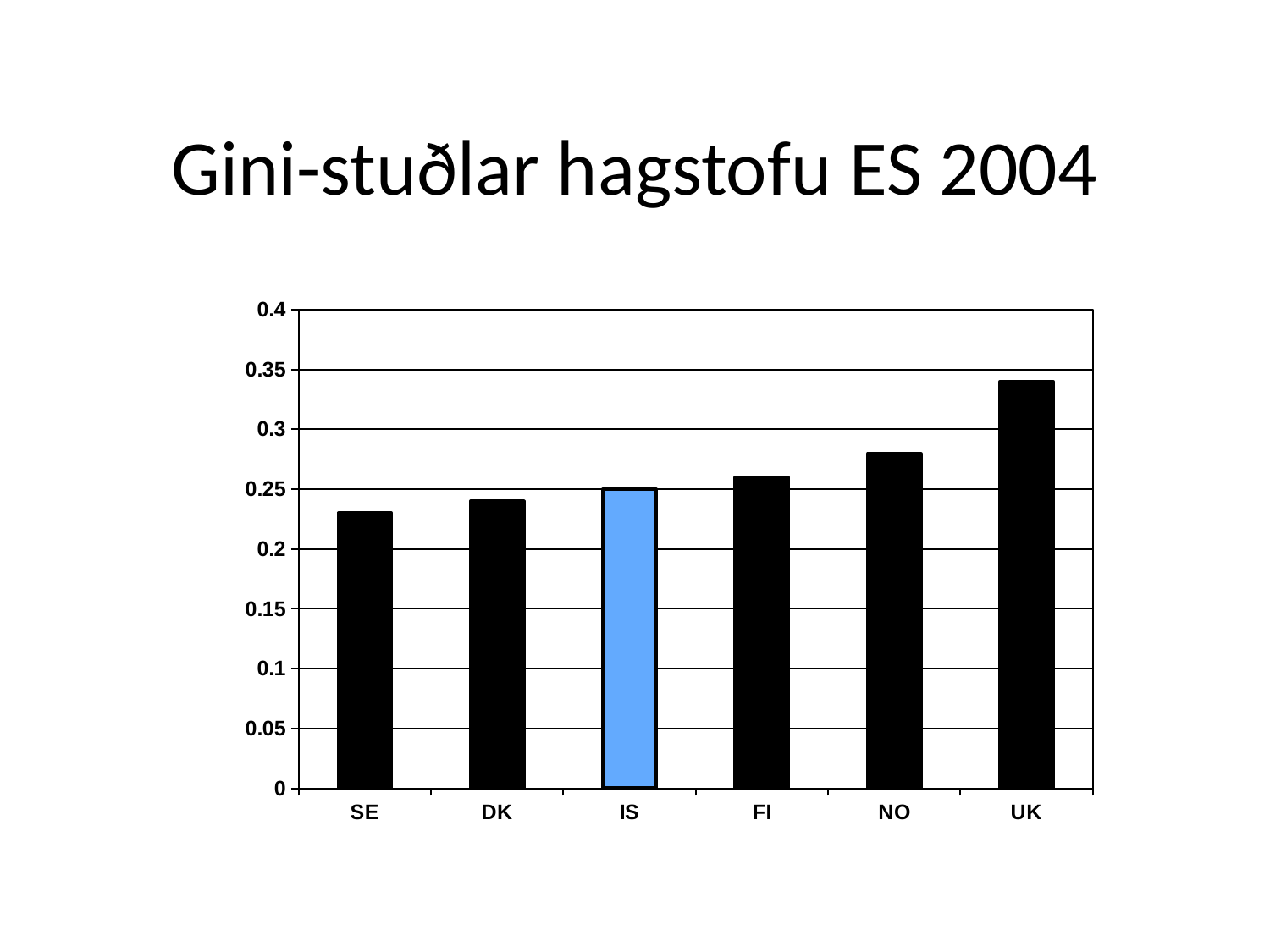
Which country has the highest Gini coefficient in the chart? UK Is the value for DK greater or less than 0.25? less Is the value for UK greater or less than 0.3? greater Do the values rise or fall moving from SE to UK along the x axis? rise Which has the larger value, UK or FI? UK What kind of chart is shown on the slide? bar chart Is the value for SE greater or less than 0.25? less Which country's bar is coloured blue instead of black? IS Which country has the lowest Gini coefficient in the chart? SE Which has the larger value, NO or SE? NO How many countries are shown on the x axis of the chart? 6